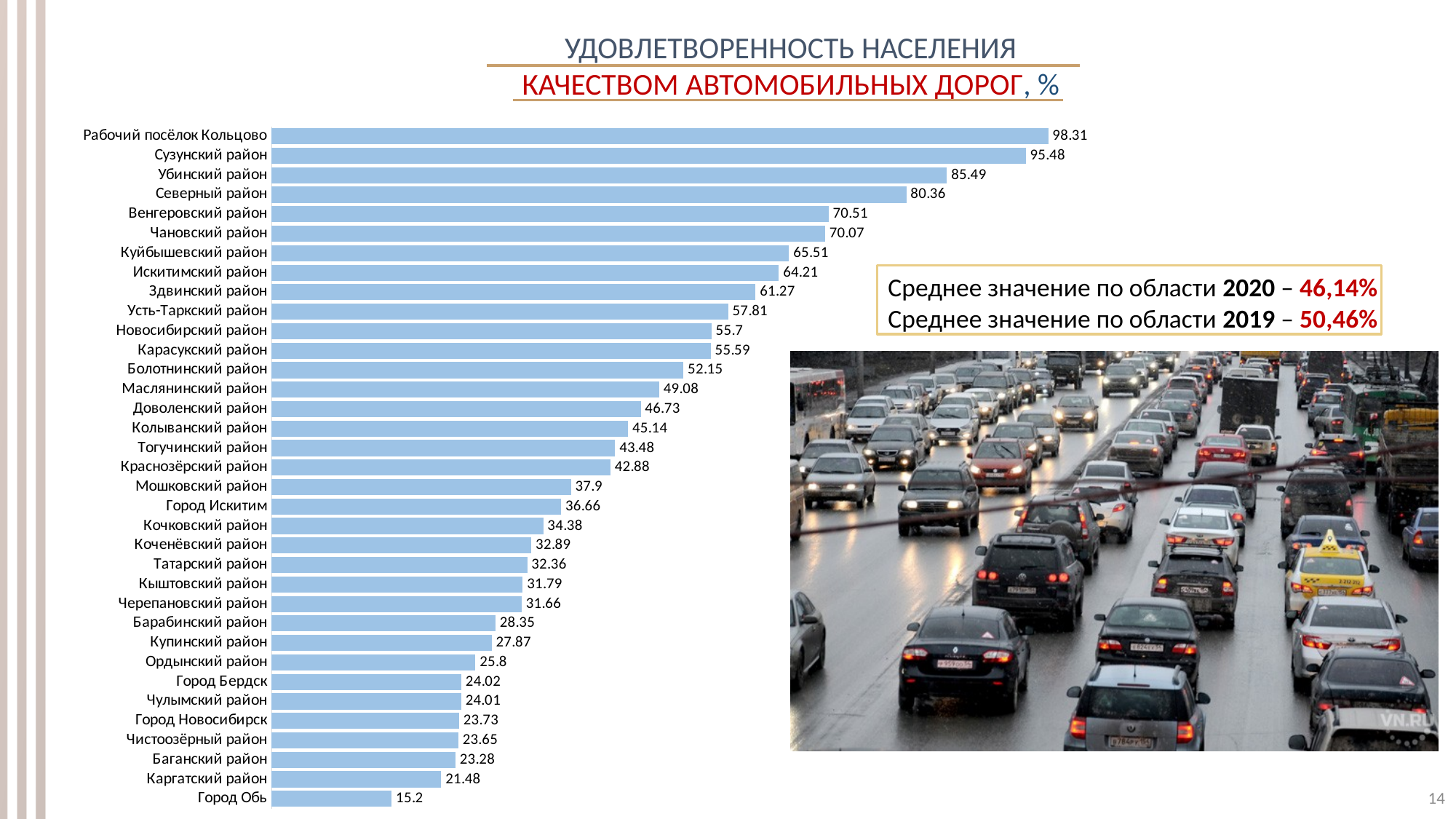
Which category has the lowest value? Город Обь Which is larger, the value for Город Искитим or the value for Город Бердск? Город Искитим According to the text box on the slide, what was the regional average value in 2020? 46,14% What is the value for Город Новосибирск? 23.73 Which category has the highest value? Рабочий посёлок Кольцово What is the difference between the values for Венгеровский район and Чановский район? 0.44 How many categories are shown in the chart? 35 What is the difference between the values for Рабочий посёлок Кольцово and Город Обь? 83.11 What is the value for Усть-Таркский район? 57.81 What is the value for Сузунский район? 95.48 What is the value for Мошковский район? 37.9 What kind of chart is shown on the slide? Bar chart